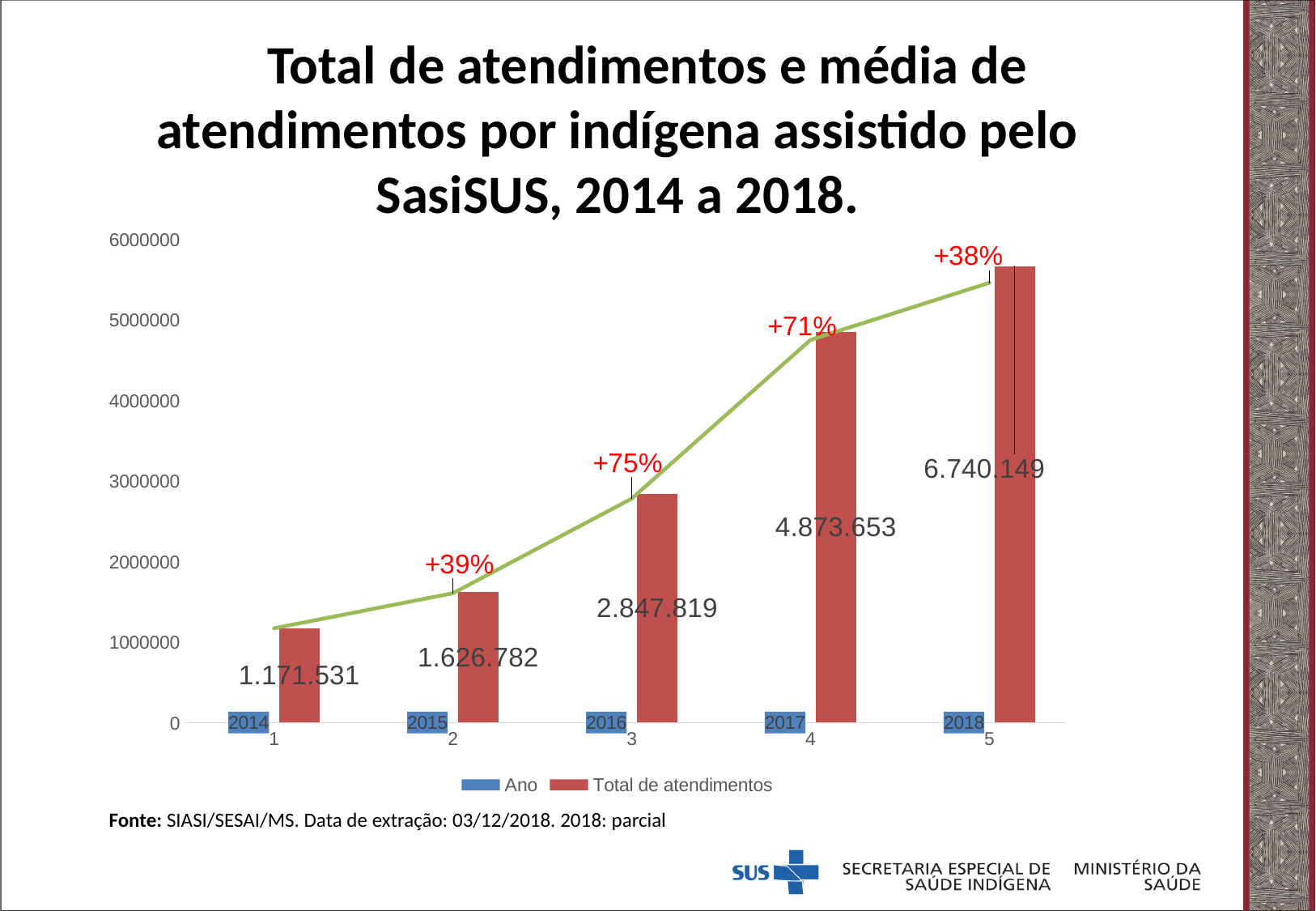
Does the Total de atendimentos rise or fall from 2014 to 2018? rise What percentage change is labelled above the 2017 bar? +71% Which is larger, the Total de atendimentos for 2016 or for 2017? 2017 Which year has the highest Total de atendimentos? 2018 Which year has the lowest Total de atendimentos? 2014 How many series does the legend list? 2 Is the Total de atendimentos bar for 2017 greater or less than 4000000 on the axis? greater What is the value of Total de atendimentos for 2014? 1.171.531 What percentage change is labelled above the 2016 bar? +75% What is the difference between the Total de atendimentos for 2015 and 2014? 455.251 What is the value of Total de atendimentos for 2018? 6.740.149 What is the value of Total de atendimentos for 2016? 2.847.819